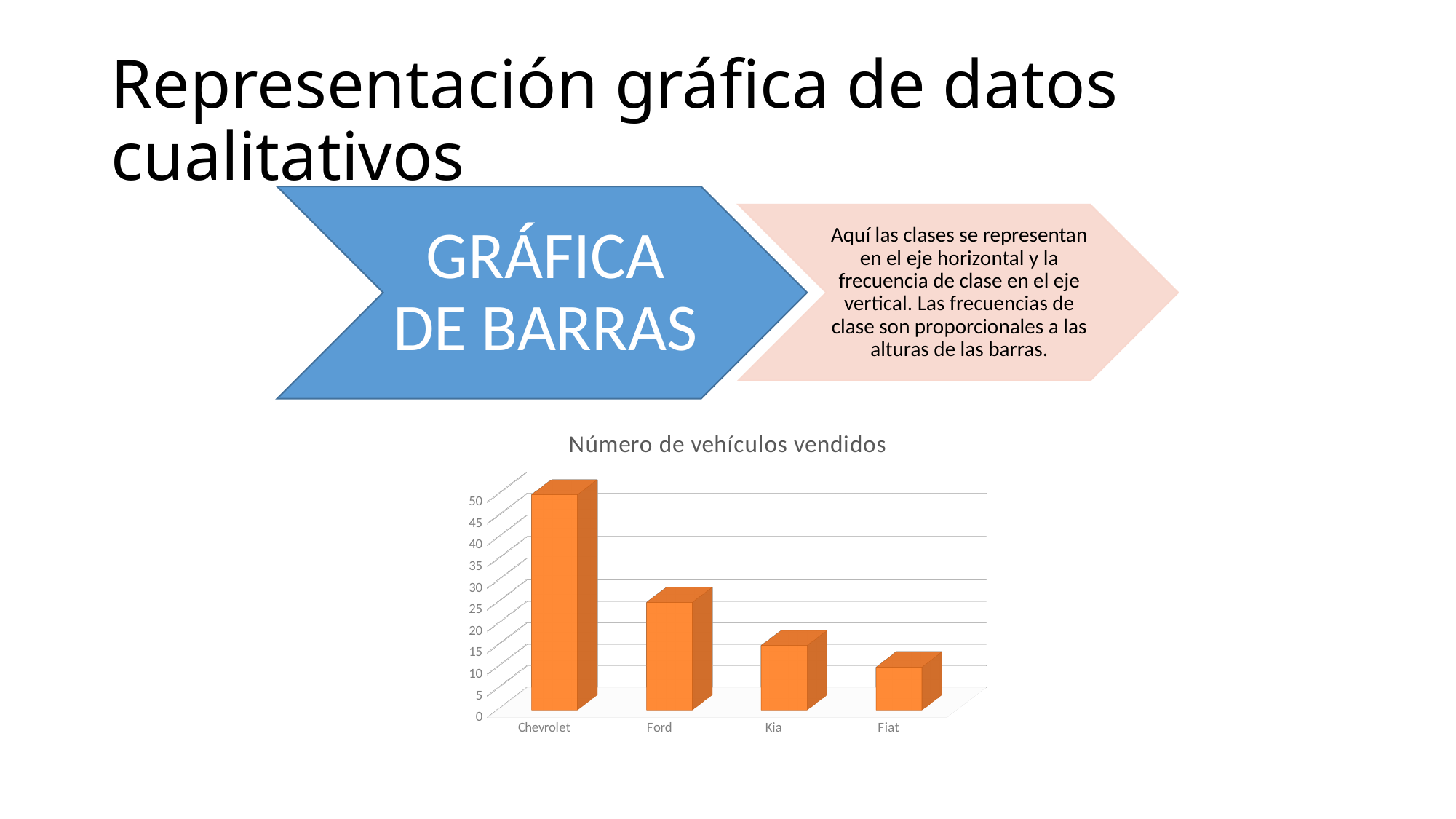
How many categories are shown on the x axis of the chart? 4 Do the values rise or fall from left to right along the x axis? fall What kind of chart is shown on the slide? bar chart Which category has the lowest value in the chart? Fiat Which is larger, the value for Kia or the value for Fiat? Kia Is the value for Kia greater or less than 20? less Is the value for Chevrolet greater or less than 40? greater Is the value for Ford greater or less than 35? less What is the title of the chart? Número de vehículos vendidos Which is larger, the value for Ford or the value for Kia? Ford Which category has the highest value in the chart? Chevrolet